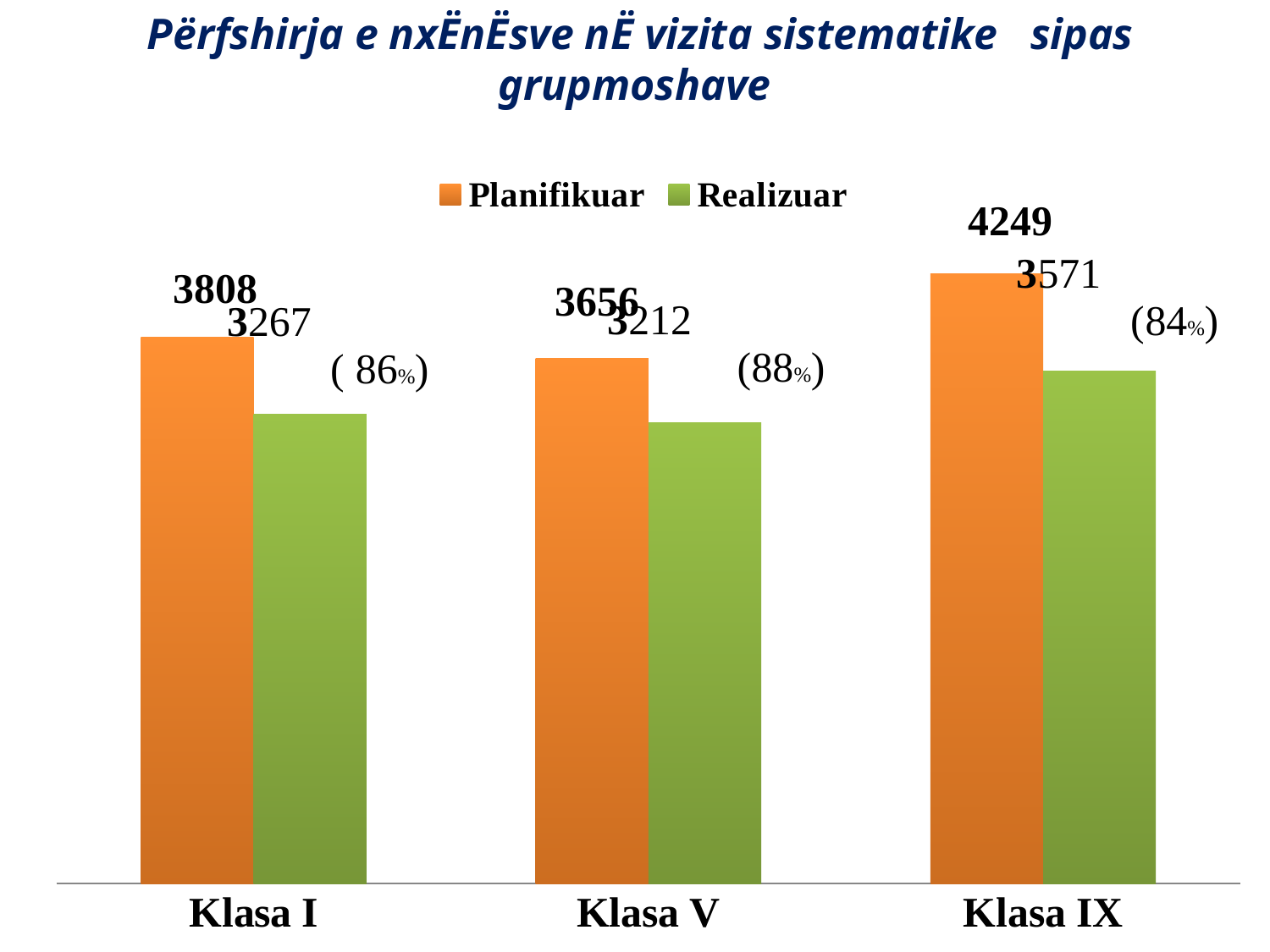
What is the Planifikuar value for Klasa IX? 4249 How many classes (categories) are shown on the x axis? 3 What is the Planifikuar value for Klasa I? 3808 How many series does the legend list? 2 Which class has the lowest Realizuar value? Klasa V What kind of chart is shown on the slide? Bar chart Which class has the highest Planifikuar value? Klasa IX What is the difference between the Planifikuar and Realizuar values for Klasa I? 541 What is the Realizuar value for Klasa IX? 3571 What percentage is shown next to the Realizuar value for Klasa V? 88% What is the Realizuar value for Klasa V? 3212 Which is larger: the Realizuar value for Klasa I or the Realizuar value for Klasa V? Klasa I